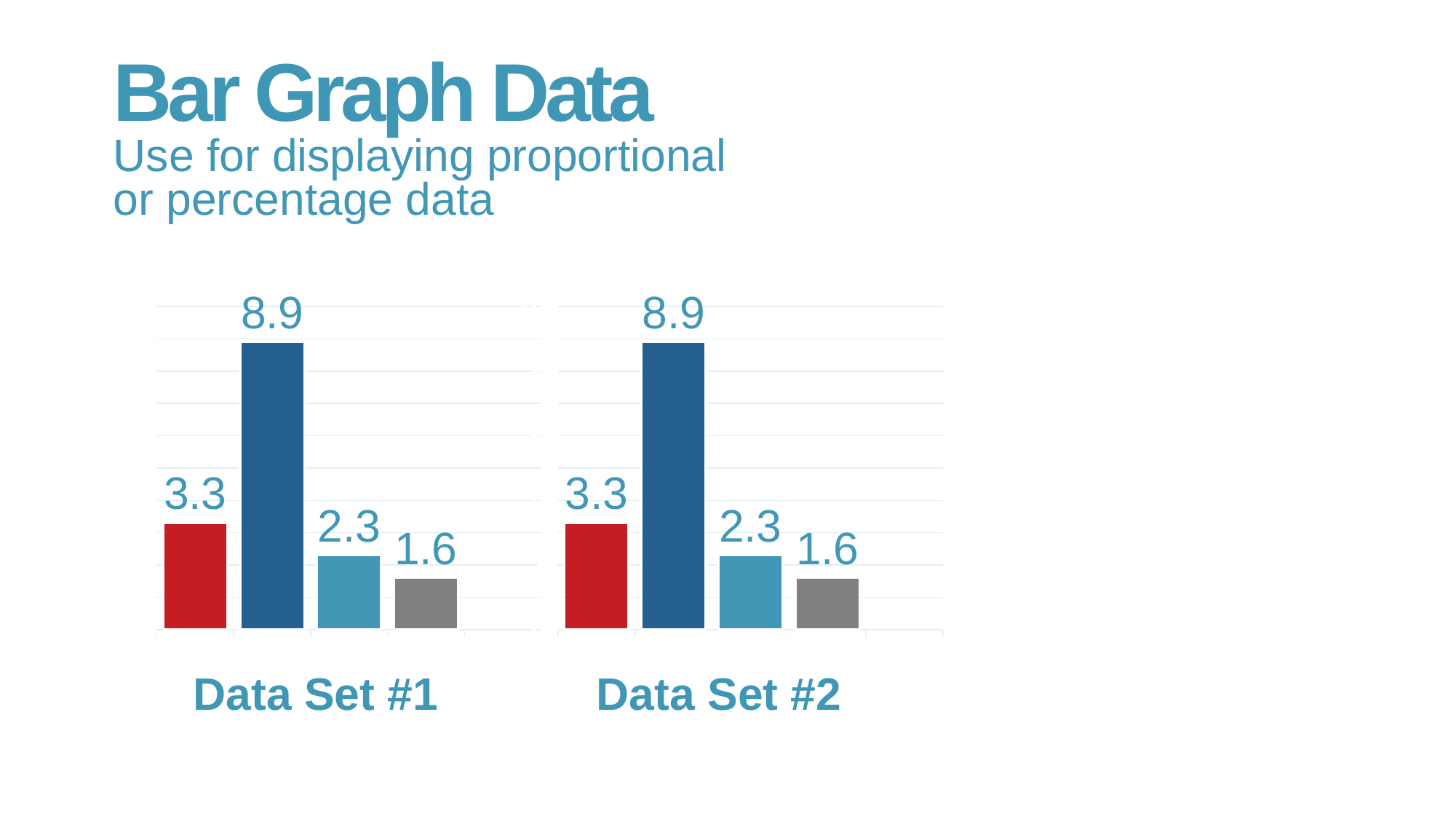
In the Data Set #1 chart, which is larger, the red bar or the light blue bar? The red bar What type of chart is used for Data Set #1? Bar chart In the Data Set #2 chart, what is the difference between the light blue bar and the gray bar? 0.7 In the Data Set #1 chart, which bar has the highest value? The dark blue bar (8.9) What is the title of the chart on the right side of the slide? Data Set #2 In the Data Set #1 chart, what value is shown on the gray bar? 1.6 How many bars are plotted in the Data Set #2 chart? 4 In the Data Set #1 chart, what is the difference between the dark blue bar and the red bar? 5.6 In the Data Set #2 chart, what value is shown on the light blue bar? 2.3 In the Data Set #2 chart, what value is shown on the dark blue bar? 8.9 In the Data Set #1 chart, what value is shown on the red bar? 3.3 In the Data Set #2 chart, which bar has the lowest value? The gray bar (1.6)